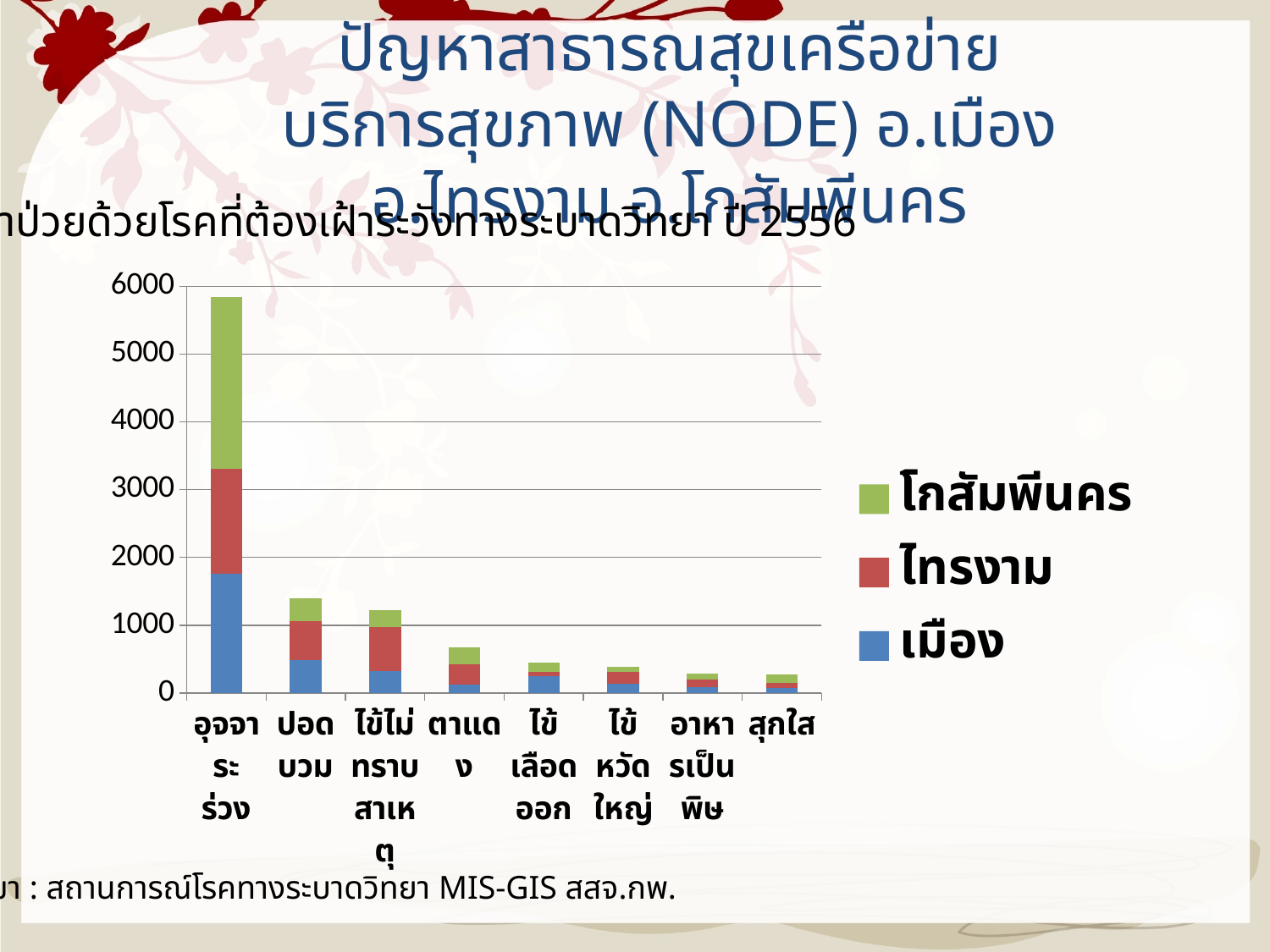
Which disease category has the tallest stacked bar? อุจจาระร่วง Is the total stacked value for ปอดบวม greater or less than 1000? greater Is the เมือง value for อุจจาระร่วง greater or less than 2000? less How many series does the chart legend list? 3 Which has the taller stacked bar, ปอดบวม or ไข้ไม่ทราบสาเหตุ? ปอดบวม Do the stacked bar totals generally rise or fall from left to right along the x axis? fall What kind of chart is shown on the slide? stacked bar chart Which series is listed last (at the bottom) in the chart legend? เมือง Is the total stacked value for ตาแดง greater or less than 1000? less Which series is shown in green in the chart legend? โกสัมพีนคร How many disease categories are shown on the x axis of the chart? 8